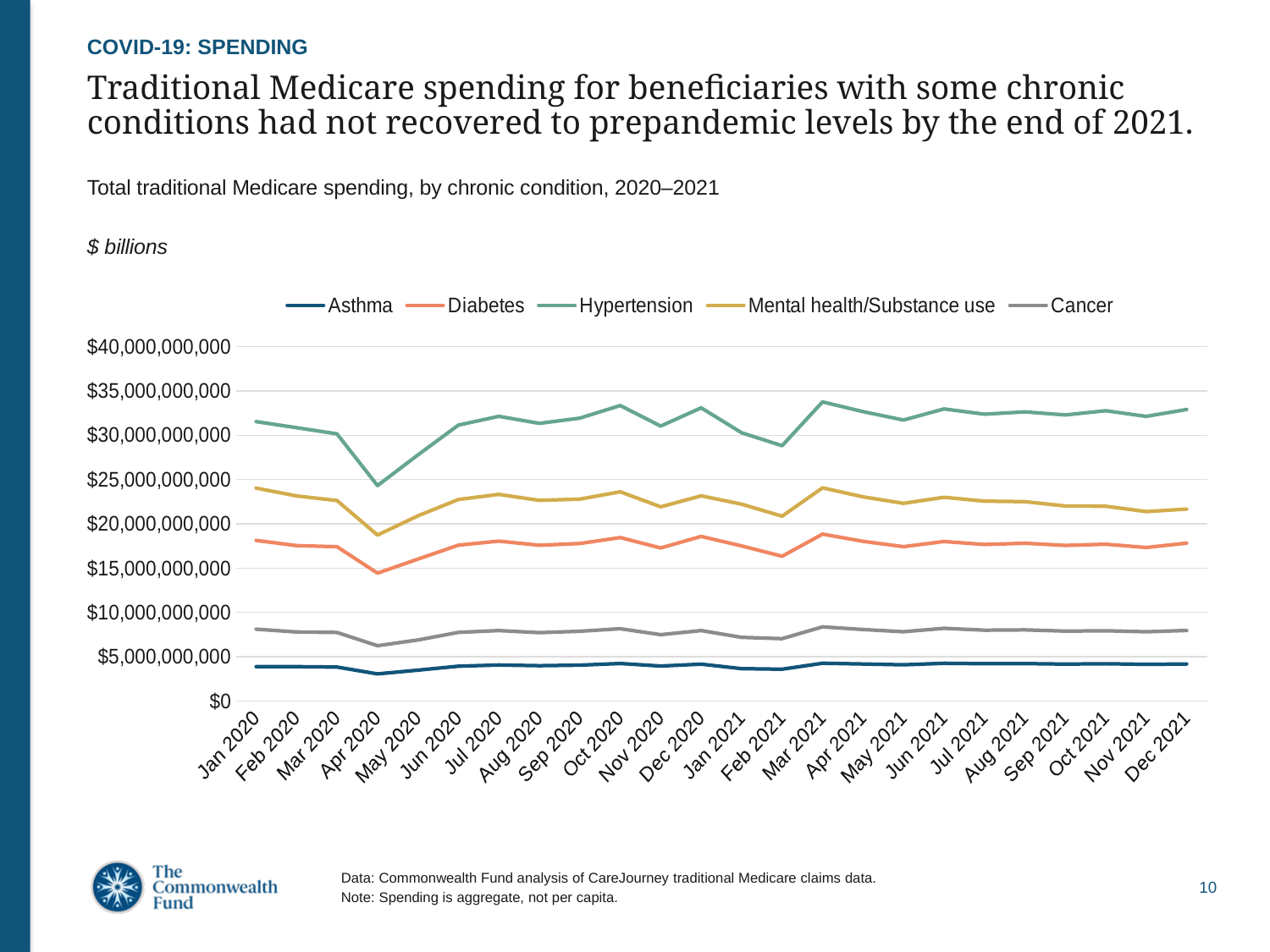
Is the value for Hypertension in Mar 2021 greater or less than $30,000,000,000? greater What kind of chart is shown on the slide? line chart Does Hypertension spending rise or fall from Mar 2020 to Apr 2020? fall How many series does the legend list? 5 Is the value for Mental health/Substance use in Apr 2020 greater or less than $20,000,000,000? less Which chronic condition has the lowest spending across the whole period? Asthma In Jan 2020, which is larger: spending for Diabetes or for Mental health/Substance use? Mental health/Substance use Is the value for Cancer in Mar 2021 greater or less than $10,000,000,000? less In which month does Hypertension spending reach its lowest point? Apr 2020 Which chronic condition has the highest spending across the whole period? Hypertension What unit is the y axis expressed in, according to the label above the chart? $ billions How many months are plotted along the x axis? 24